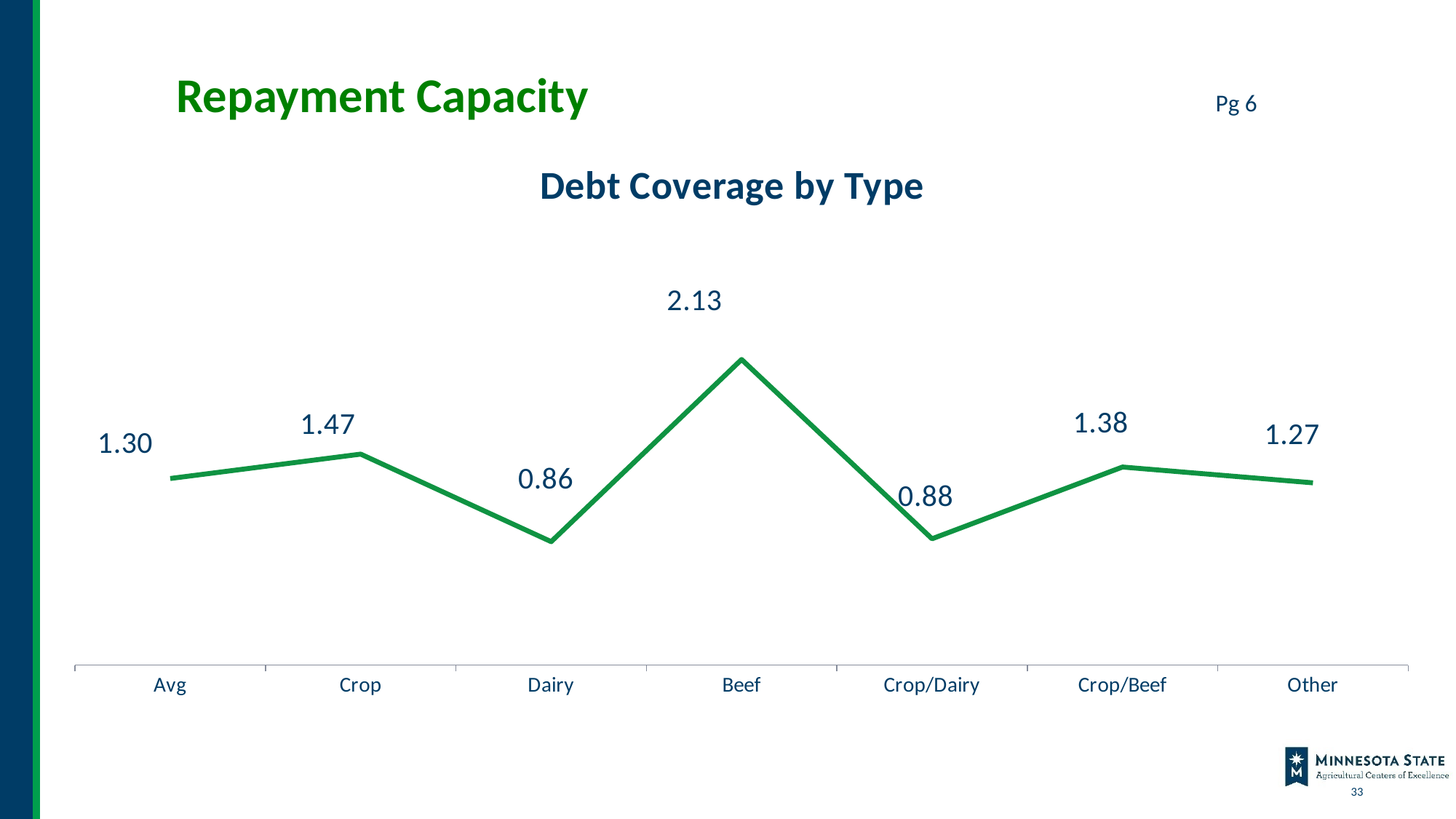
What kind of chart is shown? Line chart Does the debt coverage rise or fall from Crop to Dairy? Fall How many types are plotted on the chart? 7 Which type has the highest debt coverage? Beef What is the debt coverage value for Avg? 1.30 Which has a higher debt coverage, Crop or Other? Crop What is the debt coverage value for Beef? 2.13 What is the difference between the debt coverage for Beef and for Crop? 0.66 What is the title of the chart? Debt Coverage by Type Which type has the lowest debt coverage? Dairy What is the debt coverage value for Dairy? 0.86 What is the debt coverage value for Crop/Beef? 1.38